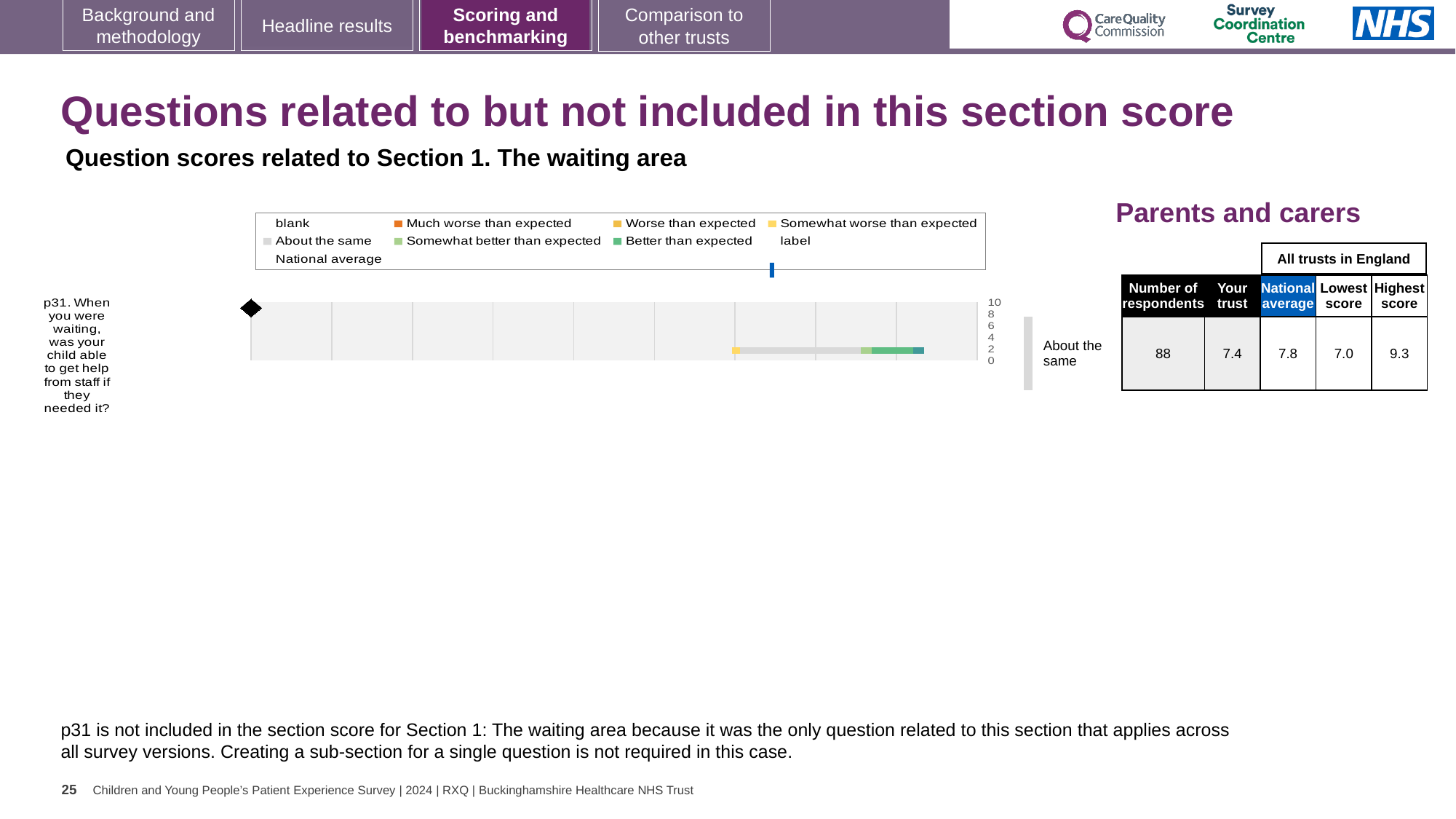
What benchmark category is shown next to the chart for p31? About the same In the table beside the chart, what is the Lowest score among all trusts in England for p31? 7.0 In the table beside the chart, what is the Highest score among all trusts in England for p31? 9.3 What is the difference between the Highest score and the Lowest score for p31 in the table beside the chart? 2.3 In the table beside the chart, what is the National average score for p31? 7.8 Which is larger for p31: the 'Your trust' score or the National average? National average In the table beside the chart, what is the 'Your trust' score for p31? 7.4 What kind of chart is shown on the slide? bar chart Which legend entry is shown in dark green in the chart legend? Better than expected How many questions (categories) are plotted in the chart? 1 Which question is plotted in the chart? p31. When you were waiting, was your child able to get help from staff if they needed it? How many respondents answered p31 according to the table beside the chart? 88